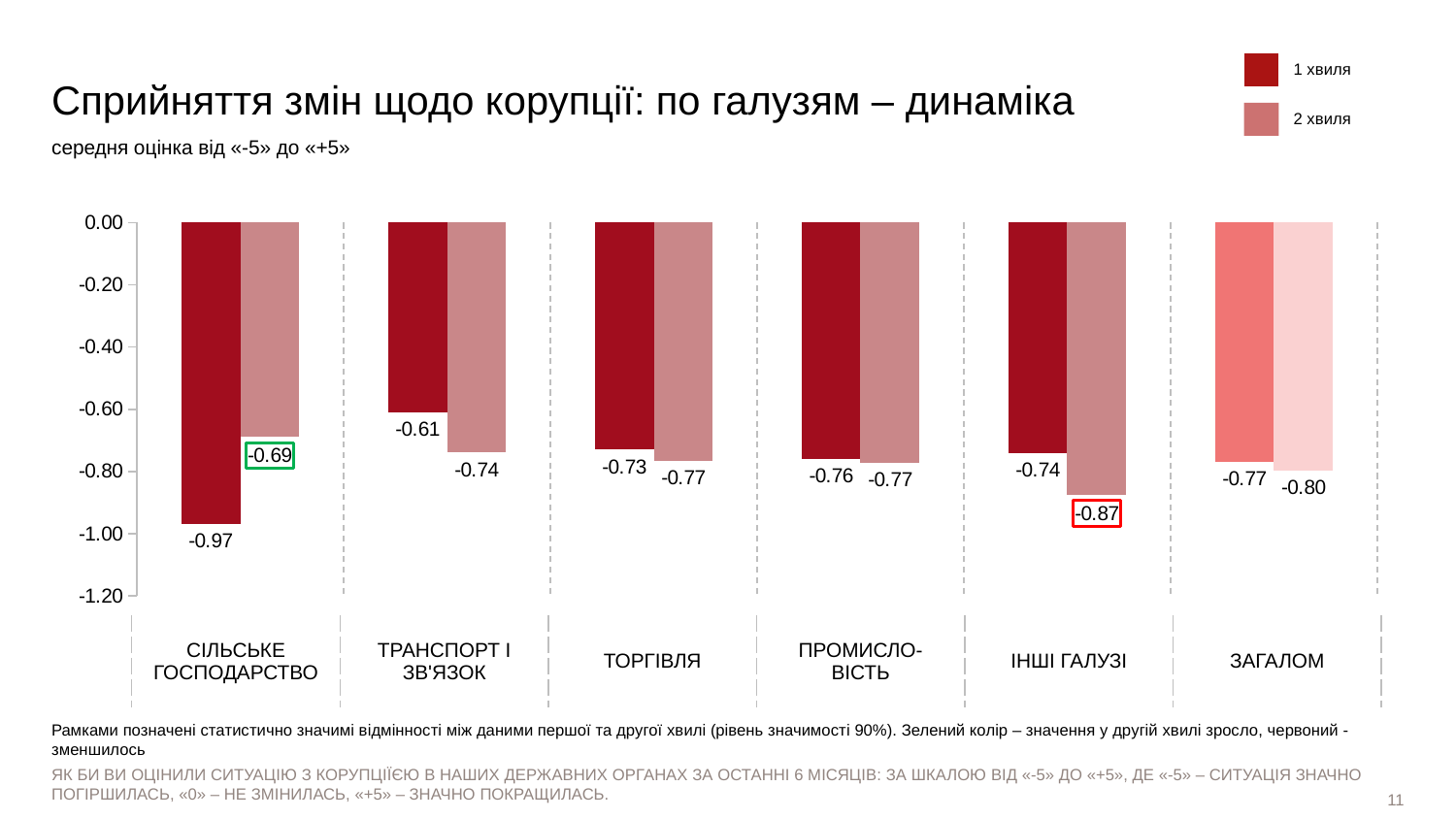
What is the value for Інші галузі in the 2 хвиля series? -0.87 Which is larger for Торгівля: the 1 хвиля value or the 2 хвиля value? 1 хвиля What is the 2 хвиля value for Загалом? -0.80 Which category has the highest value in the 1 хвиля series? Транспорт і зв'язок What kind of chart is shown on the slide? Bar chart What is the difference between the 1 хвиля and 2 хвиля values for Сільське господарство? 0.28 What is the value for Сільське господарство in the 1 хвиля series? -0.97 What is the 1 хвиля value for Транспорт і зв'язок? -0.61 How many series does the legend list? 2 How many categories are shown on the x axis? 6 Which category has the lowest value in the 1 хвиля series? Сільське господарство Which category has the lowest value in the 2 хвиля series? Інші галузі